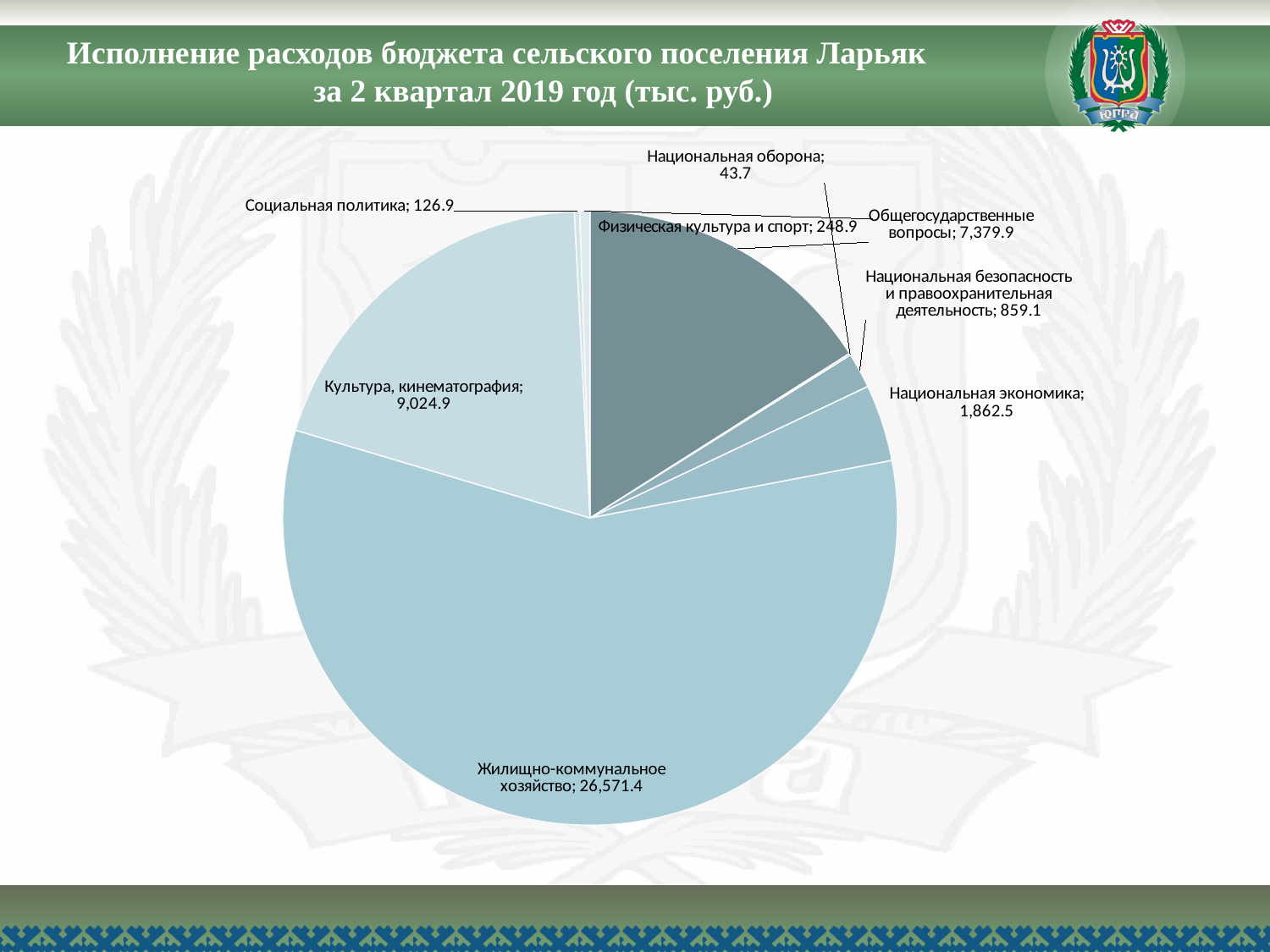
What is the difference between Национальная экономика and Национальная безопасность и правоохранительная деятельность? 1,003.4 Which is larger: Физическая культура и спорт or Социальная политика? Физическая культура и спорт What is the value for Жилищно-коммунальное хозяйство? 26,571.4 What type of chart is shown on the slide? pie chart What is the value for Общегосударственные вопросы? 7,379.9 What is the value for Национальная экономика? 1,862.5 Which category has the smallest value? Национальная оборона How many categories are shown in the pie chart? 8 What is the difference between Культура, кинематография and Общегосударственные вопросы? 1,645.0 Which category has the largest slice of the pie? Жилищно-коммунальное хозяйство What is the value for Национальная оборона? 43.7 What period does the chart title say the budget expenditures cover? 2 квартал 2019 год